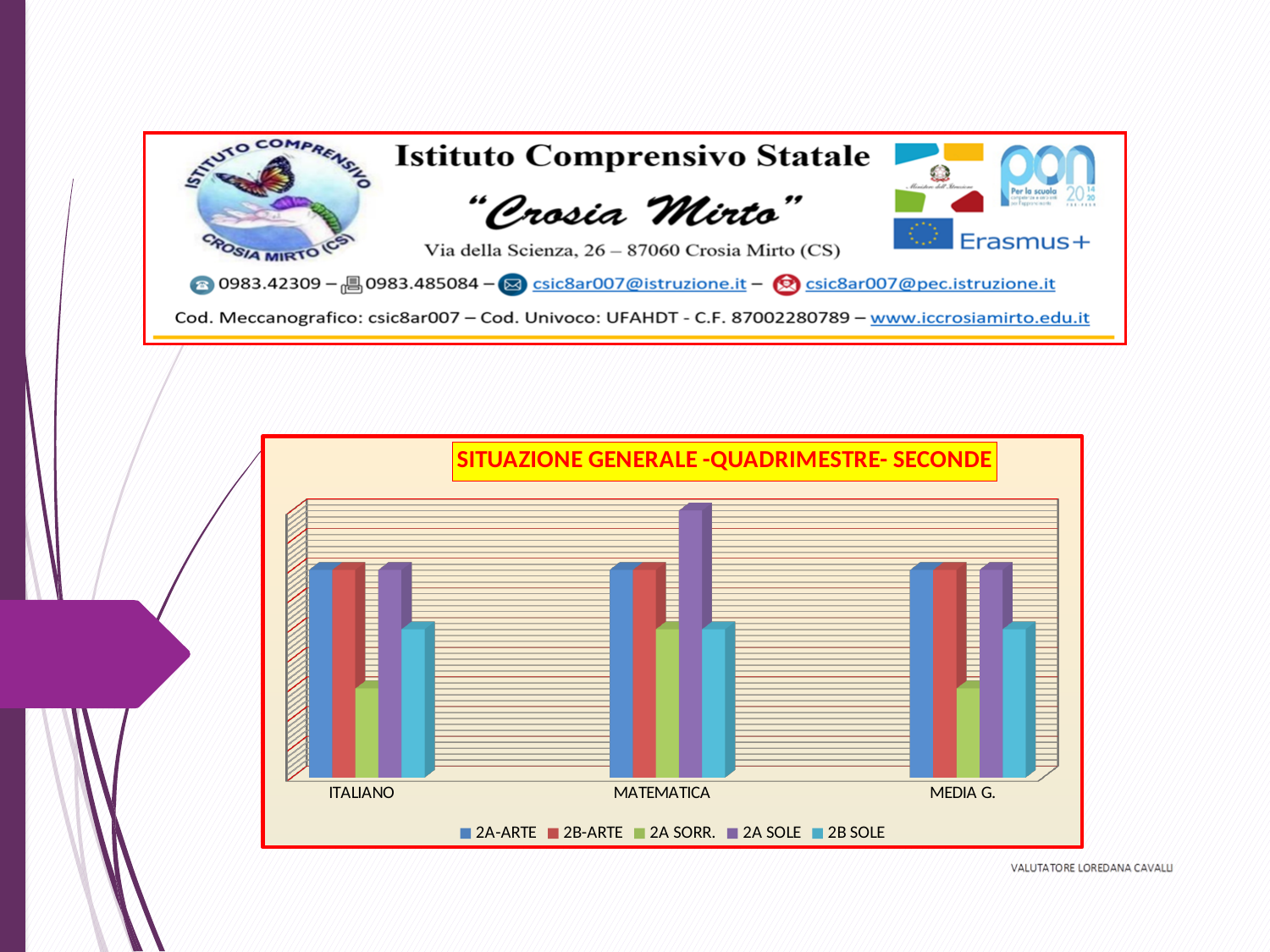
What is the title of the chart? SITUAZIONE GENERALE -QUADRIMESTRE- SECONDE In which category does the tallest bar of the whole chart appear? MATEMATICA Which series has the highest bar in the MATEMATICA category? 2A SOLE In the MEDIA G. category, which is larger: the bar for 2A-ARTE or the bar for 2A SORR.? 2A-ARTE In the ITALIANO category, which is larger: the bar for 2B SOLE or the bar for 2A SORR.? 2B SOLE How many categories are shown on the x axis of the chart? 3 Which series is shown in green in the chart's legend? 2A SORR. What kind of chart is shown on the slide? bar chart How many series does the chart's legend list? 5 In the MATEMATICA category, which is larger: the bar for 2A SOLE or the bar for 2A-ARTE? 2A SOLE Which series has the lowest bar in the ITALIANO category? 2A SORR. Which series has the lowest bar in the MEDIA G. category? 2A SORR.